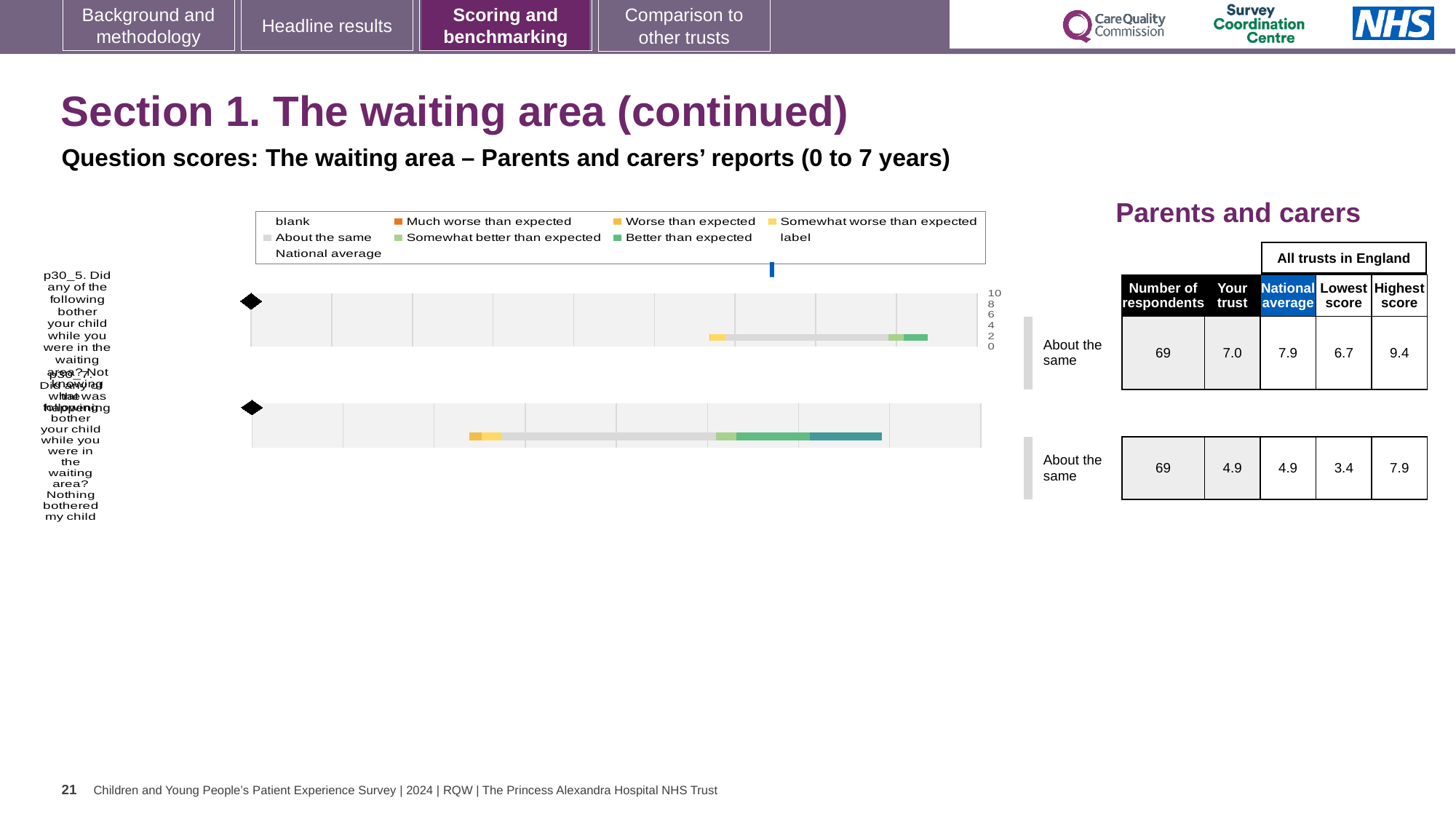
What is the maximum value shown on the chart's score axis? 10 How many respondents answered question p30_5? 69 How many questions (bars) are plotted in the chart? 2 How many entries does the chart legend list? 9 According to the table, what is the 'Your trust' score for question p30_5 (did anything bother your child in the waiting area)? 7.0 According to the table, what is the national average for question p30_5? 7.9 What colour does the legend use for 'Much worse than expected'? orange For question p30_5, which is larger: the trust's score or the national average? national average According to the table, what is the highest score across all trusts in England for question p30_7? 7.9 According to the table, what is the 'Your trust' score for question p30_7 (nothing bothered my child)? 4.9 What kind of chart is shown on the slide? bar chart For question p30_5, what is the difference between the national average and the trust's score? 0.9